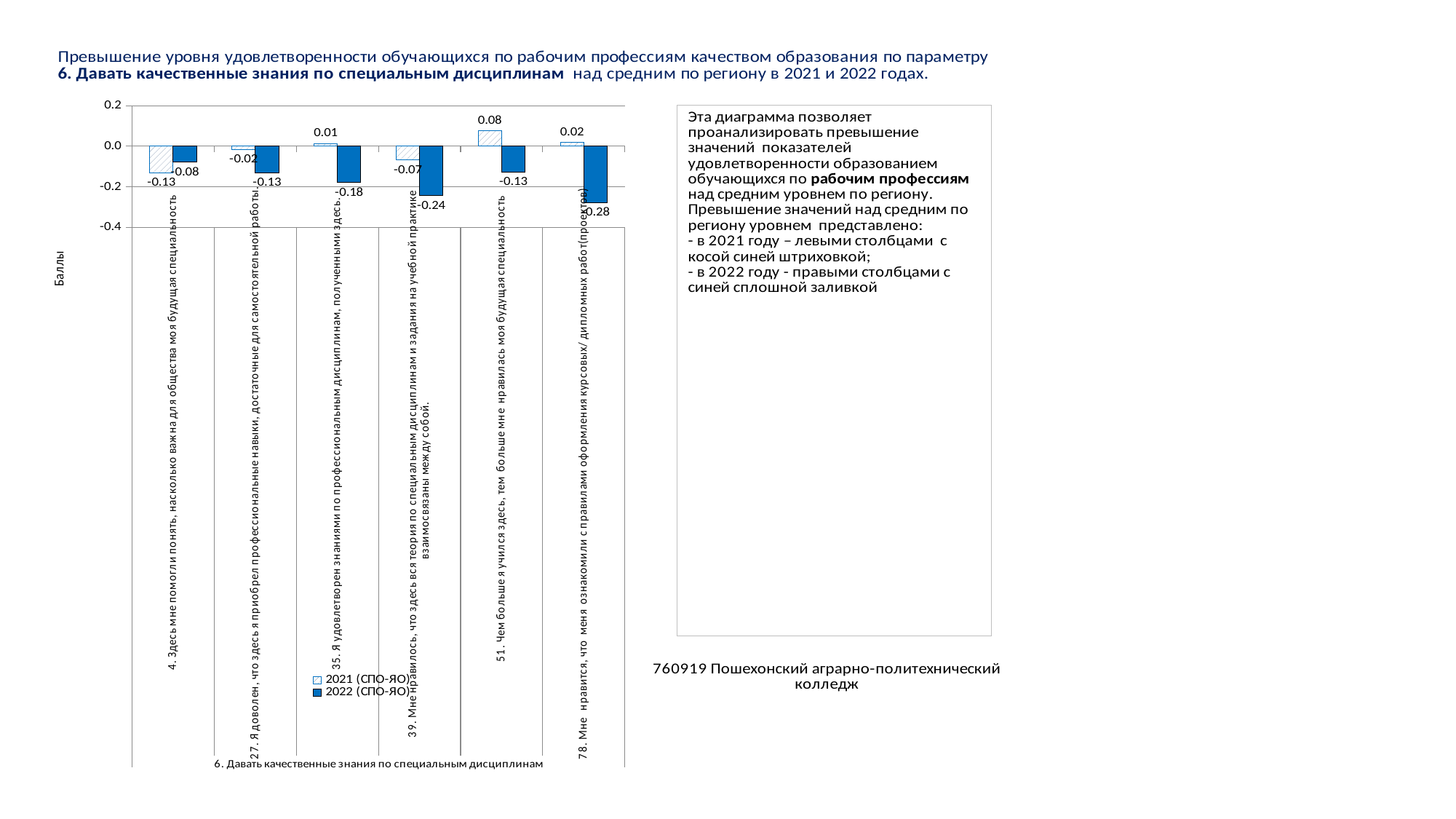
How many series does the legend list? 2 What is the 2022 (СПО-ЯО) value for statement 78 (Мне нравится, что меня ознакомили с правилами оформления курсовых/дипломных работ)? -0.28 What is the label of the vertical axis? Баллы What is the 2021 (СПО-ЯО) value for statement 4 (Здесь мне помогли понять, насколько важна для общества моя будущая специальность)? -0.13 What is the 2022 (СПО-ЯО) value for statement 39 (Мне нравилось, что здесь вся теория по специальным дисциплинам и задания на учебной практике взаимосвязаны между собой)? -0.24 What is the difference between the 2021 and 2022 values for statement 51? 0.21 How many categories (statements) are plotted on the x axis? 6 Which statement has the lowest 2022 (СПО-ЯО) value? 78. Мне нравится, что меня ознакомили с правилами оформления курсовых/дипломных работ(проектов) What type of chart is shown on the slide? bar chart What is the 2021 (СПО-ЯО) value for statement 51 (Чем больше я учился здесь, тем больше мне нравилась моя будущая специальность)? 0.08 Which statement has the highest 2021 (СПО-ЯО) value? 51. Чем больше я учился здесь, тем больше мне нравилась моя будущая специальность For statement 4, which series has the larger value, 2021 (СПО-ЯО) or 2022 (СПО-ЯО)? 2022 (СПО-ЯО)